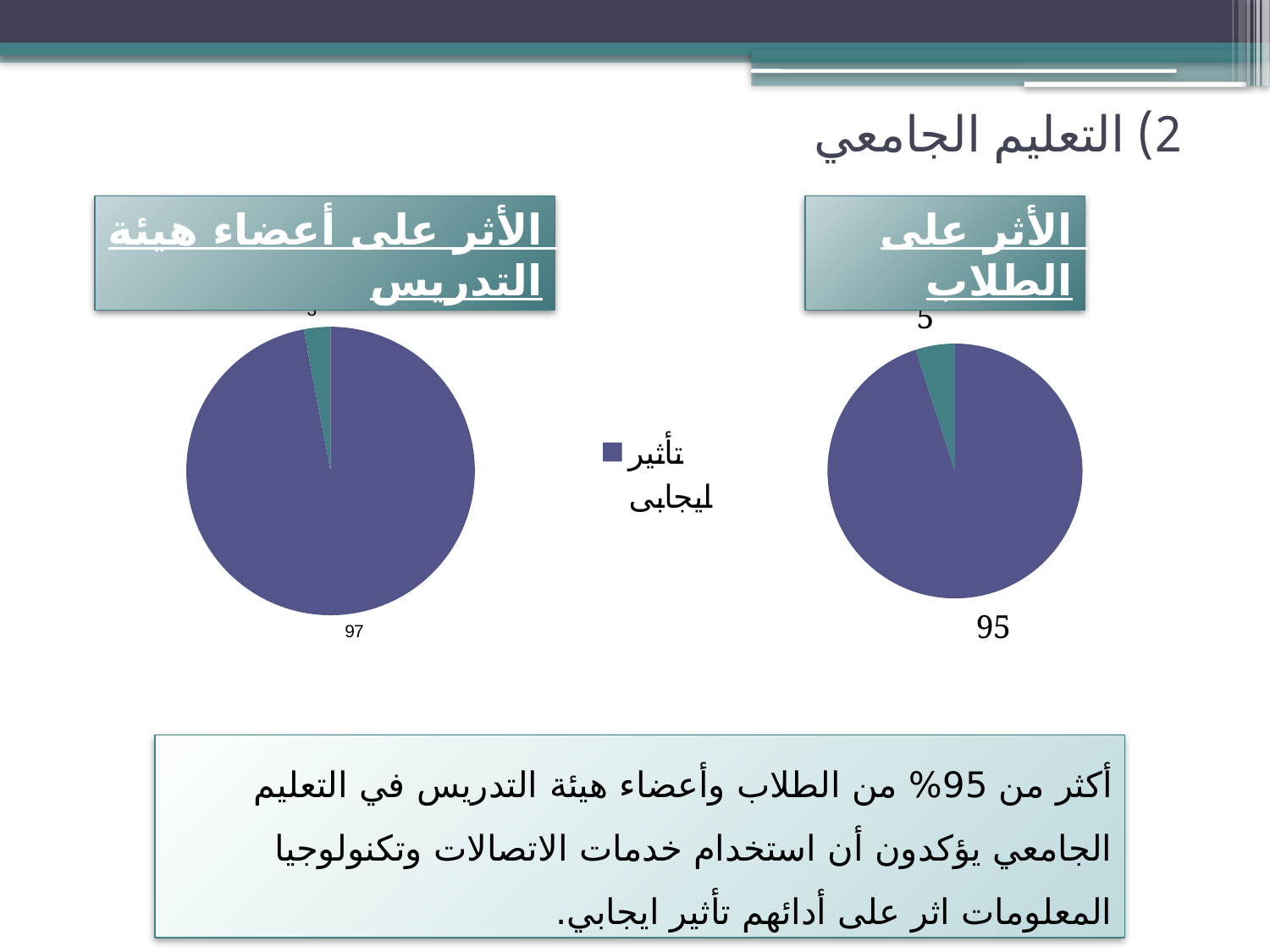
Which chart has the larger purple slice value, "الأثر على الطلاب" or "الأثر على أعضاء هيئة التدريس"? الأثر على أعضاء هيئة التدريس In the chart titled "الأثر على الطلاب", which slice is the largest? the purple slice labelled 95 What is the legend entry shown between the two pie charts? تأثير ايجابى How many slices does the chart titled "الأثر على الطلاب" have? 2 What is the difference between the large slice value in "الأثر على أعضاء هيئة التدريس" (97) and the large slice value in "الأثر على الطلاب" (95)? 2 In the chart titled "الأثر على الطلاب", what value is printed on the large purple slice? 95 How many slices does the chart titled "الأثر على أعضاء هيئة التدريس" have? 2 In the chart titled "الأثر على أعضاء هيئة التدريس" on the left, what value is printed on the large purple slice? 97 What is the title of the pie chart on the right of the slide? الأثر على الطلاب In the chart titled "الأثر على الطلاب", what value is printed on the small teal slice? 5 In the chart titled "الأثر على الطلاب", what is the difference between the two slice values? 90 What kind of chart is the chart titled "الأثر على الطلاب" on the right of the slide? pie chart